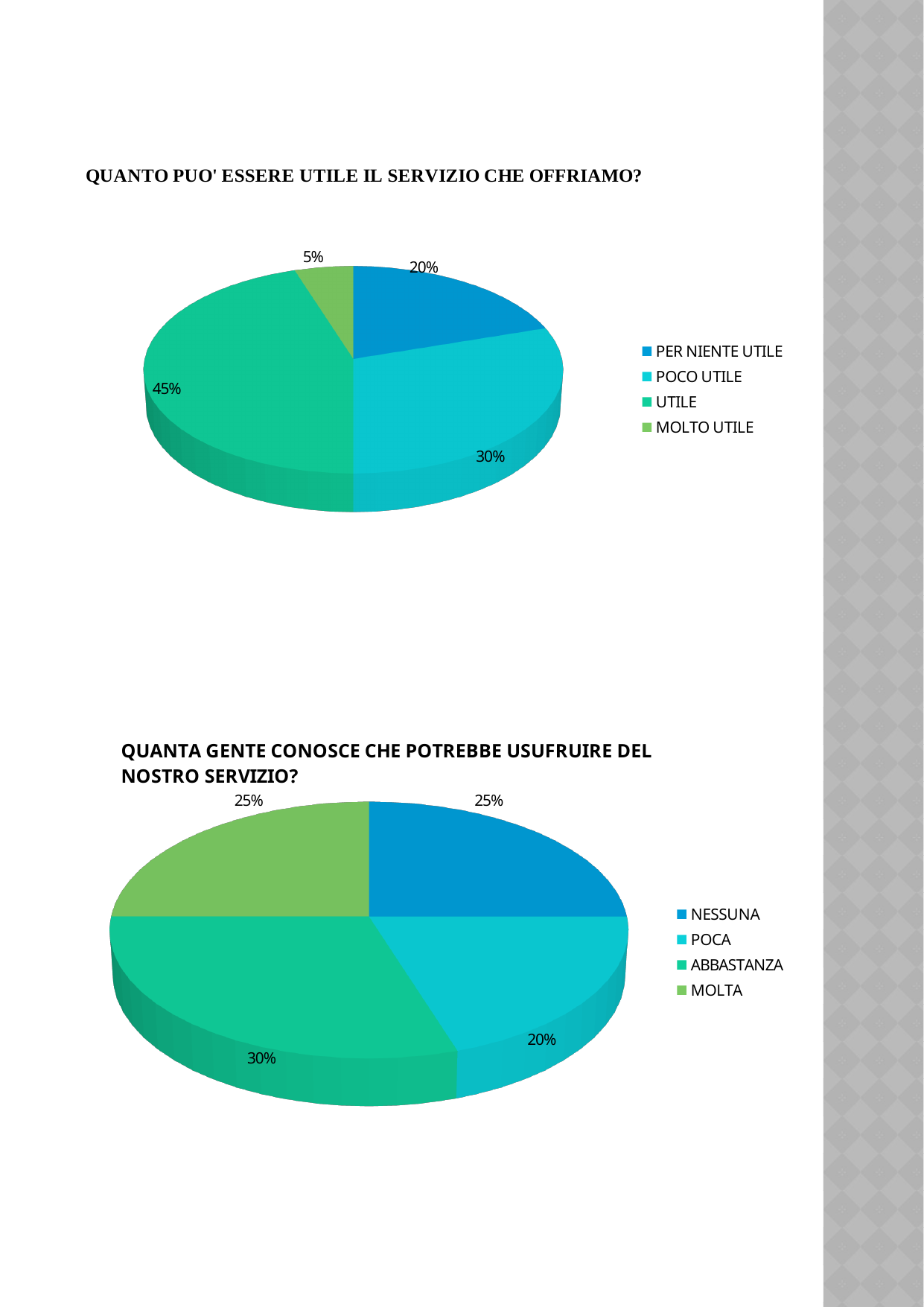
In the top chart (QUANTO PUO' ESSERE UTILE IL SERVIZIO CHE OFFRIAMO?), what share does MOLTO UTILE have? 5% In the bottom chart (QUANTA GENTE CONOSCE CHE POTREBBE USUFRUIRE DEL NOSTRO SERVIZIO?), what share does POCA have? 20% In the top chart (QUANTO PUO' ESSERE UTILE IL SERVIZIO CHE OFFRIAMO?), what share does UTILE have? 45% In the top chart (QUANTO PUO' ESSERE UTILE IL SERVIZIO CHE OFFRIAMO?), which category has the smallest slice? MOLTO UTILE In the bottom chart (QUANTA GENTE CONOSCE CHE POTREBBE USUFRUIRE DEL NOSTRO SERVIZIO?), which category has the largest slice? ABBASTANZA In the top chart (QUANTO PUO' ESSERE UTILE IL SERVIZIO CHE OFFRIAMO?), what is the difference between the POCO UTILE and PER NIENTE UTILE shares? 10% In the top chart (QUANTO PUO' ESSERE UTILE IL SERVIZIO CHE OFFRIAMO?), how many categories does the legend list? 4 In the bottom chart (QUANTA GENTE CONOSCE CHE POTREBBE USUFRUIRE DEL NOSTRO SERVIZIO?), what share does ABBASTANZA have? 30% What kind of chart is the top chart (QUANTO PUO' ESSERE UTILE IL SERVIZIO CHE OFFRIAMO?)? Pie chart In the top chart (QUANTO PUO' ESSERE UTILE IL SERVIZIO CHE OFFRIAMO?), which category has the largest slice? UTILE In the bottom chart (QUANTA GENTE CONOSCE CHE POTREBBE USUFRUIRE DEL NOSTRO SERVIZIO?), what colour is the MOLTA slice? Green In the bottom chart (QUANTA GENTE CONOSCE CHE POTREBBE USUFRUIRE DEL NOSTRO SERVIZIO?), which is larger, NESSUNA or POCA? NESSUNA